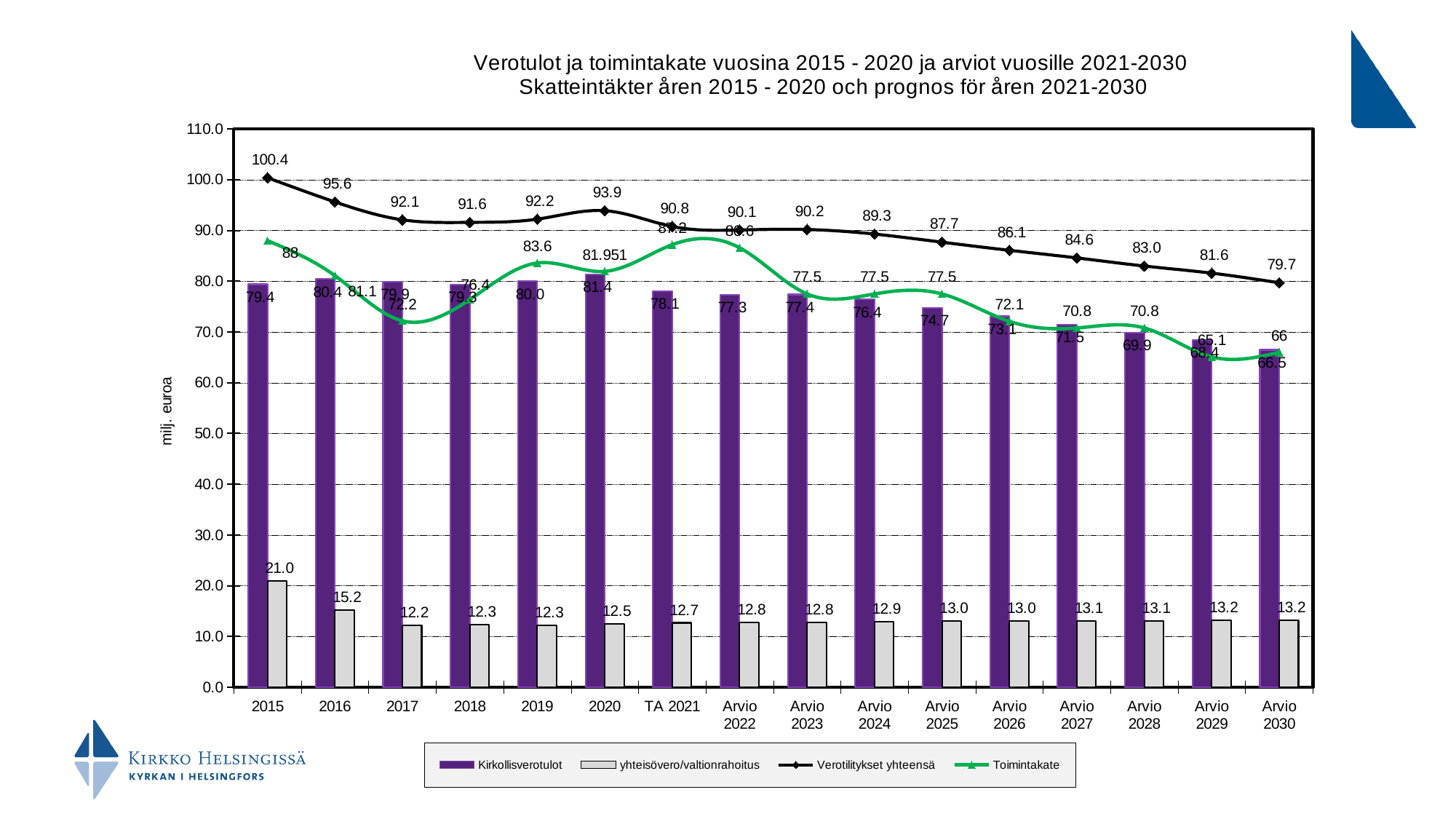
What is the difference between Verotilitykset yhteensä in 2015 and in Arvio 2030? 20.7 What kind of chart is this? Combined bar and line chart What is the value of Verotilitykset yhteensä for 2015? 100.4 What is the value of yhteisövero/valtionrahoitus for 2015? 21.0 Does Verotilitykset yhteensä generally rise or fall from 2015 to Arvio 2030? Fall How many categories are shown on the x axis? 16 How many series does the legend list? 4 In which year is yhteisövero/valtionrahoitus lowest? 2017 Which is larger, Kirkollisverotulot in 2016 or in 2019? 2016 What is the Toimintakate value for 2017? 72.2 What is the Kirkollisverotulot value for Arvio 2030? 66.5 In which year is Kirkollisverotulot highest? 2020